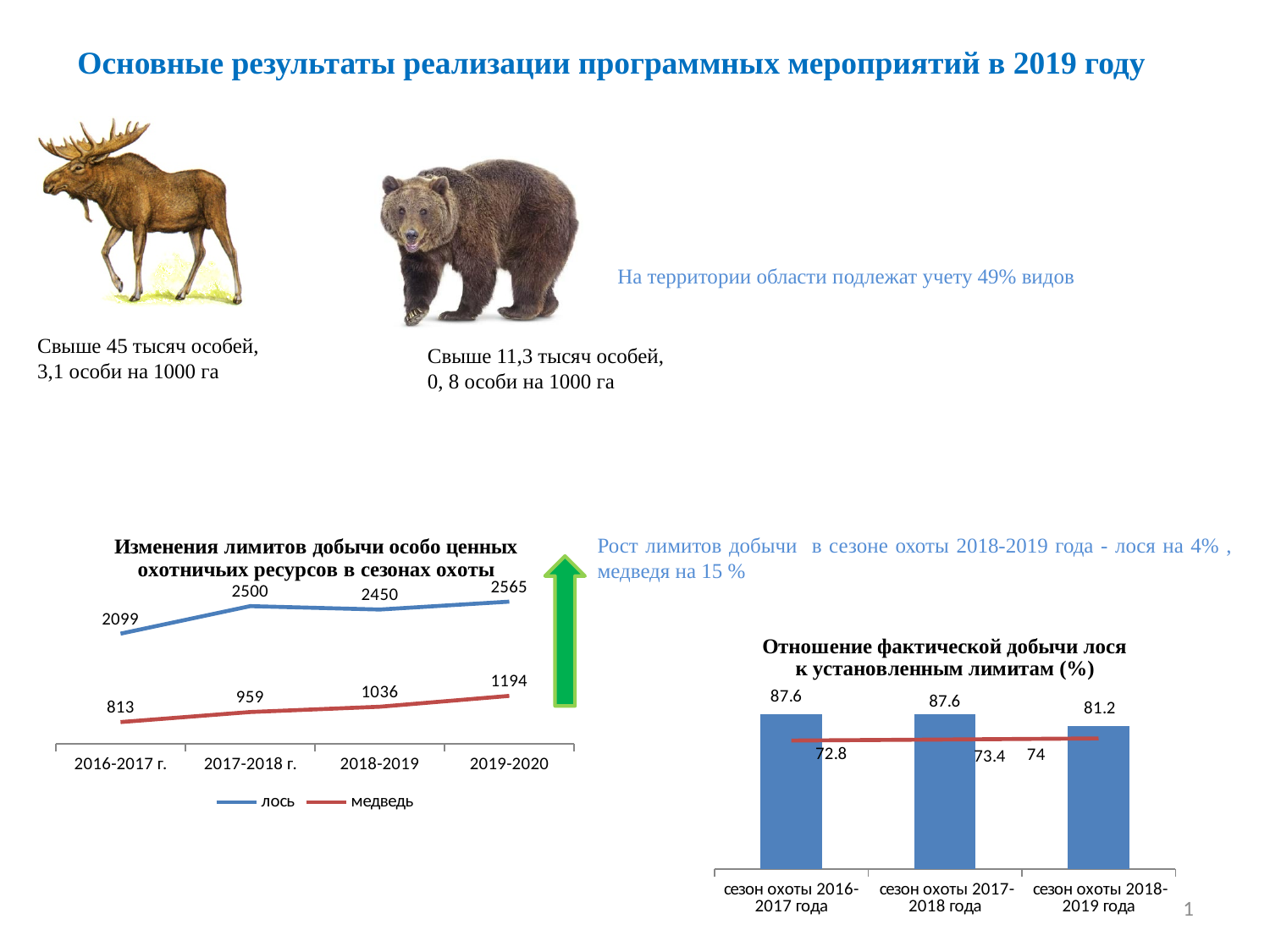
On the chart 'Изменения лимитов добычи особо ценных охотничьих ресурсов в сезонах охоты', in which season is the value for лось lowest? 2016-2017 г. What kind of chart is 'Отношение фактической добычи лося к установленным лимитам (%)'? combination bar and line chart On the chart 'Изменения лимитов добычи особо ценных охотничьих ресурсов в сезонах охоты', what is the value for медведь in 2016-2017 г.? 813 On the chart 'Изменения лимитов добычи особо ценных охотничьих ресурсов в сезонах охоты', how many seasons are shown on the x axis? 4 On the chart 'Изменения лимитов добычи особо ценных охотничьих ресурсов в сезонах охоты', what is the difference between the лось values in 2019-2020 and 2018-2019? 115 On the chart 'Изменения лимитов добычи особо ценных охотничьих ресурсов в сезонах охоты', in which season is the value for медведь highest? 2019-2020 On the chart 'Отношение фактической добычи лося к установленным лимитам (%)', which is larger: the bar for сезон охоты 2017-2018 года or the bar for сезон охоты 2018-2019 года? сезон охоты 2017-2018 года On the chart 'Отношение фактической добычи лося к установленным лимитам (%)', which season has the lowest bar value? сезон охоты 2018-2019 года On the chart 'Изменения лимитов добычи особо ценных охотничьих ресурсов в сезонах охоты', how many series does the legend list? 2 On the chart 'Изменения лимитов добычи особо ценных охотничьих ресурсов в сезонах охоты', what is the value for лось in 2019-2020? 2565 On the chart 'Изменения лимитов добычи особо ценных охотничьих ресурсов в сезонах охоты', does the медведь series rise or fall from 2016-2017 г. to 2019-2020? rise On the chart 'Отношение фактической добычи лося к установленным лимитам (%)', what is the bar value for сезон охоты 2018-2019 года? 81.2